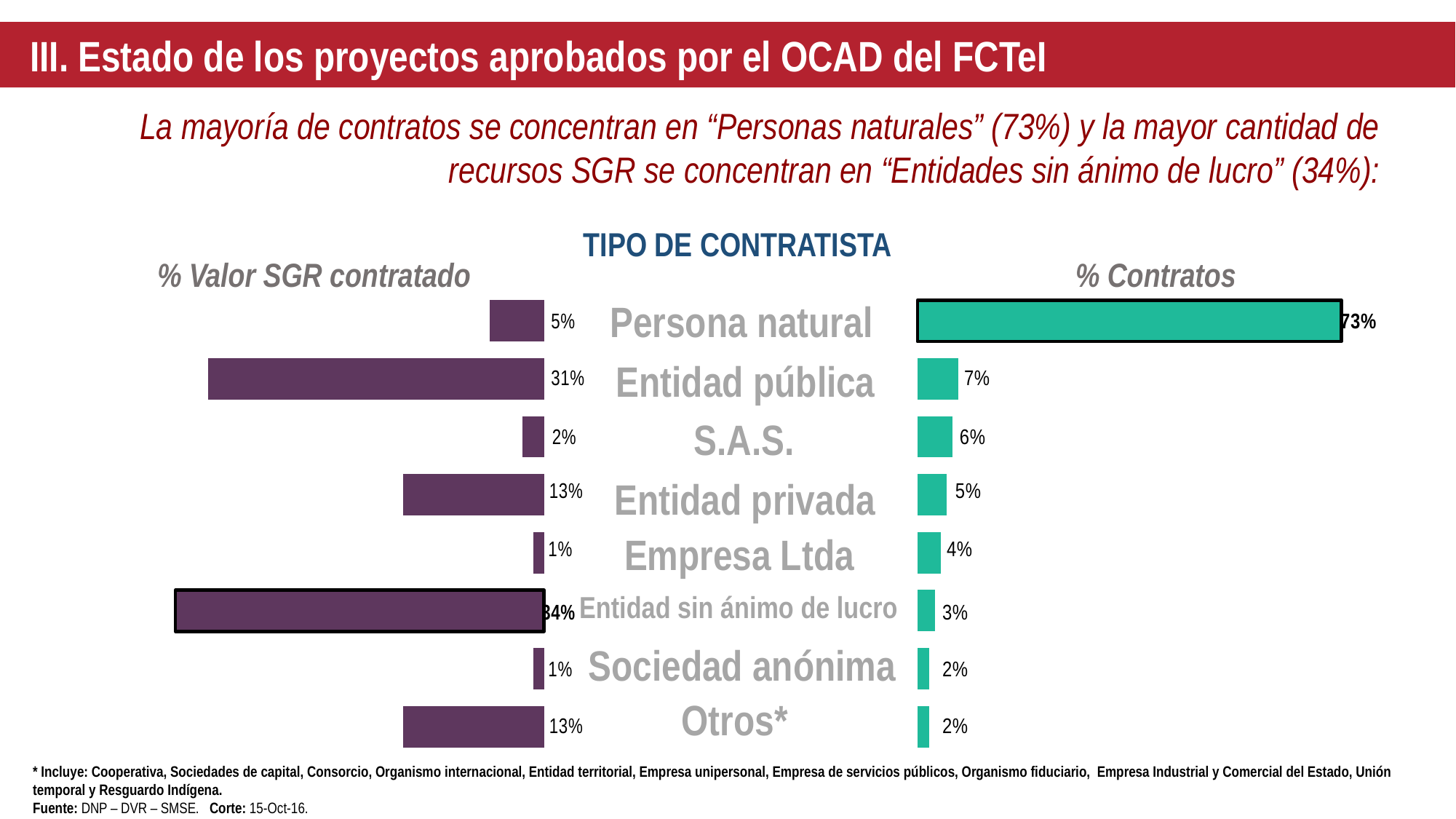
In the "% Valor SGR contratado" chart, which is larger: Entidad privada or Persona natural? Entidad privada What is the title shown above the two charts? TIPO DE CONTRATISTA In the "% Valor SGR contratado" chart, what is the value for Entidad pública? 31% In the "% Contratos" chart, which category has the highest value? Persona natural In the "% Contratos" chart, what is the difference between Persona natural and Entidad pública? 66% How many contractor-type categories are shown in the "% Valor SGR contratado" chart? 8 What type of chart is the "% Contratos" chart? Bar chart In the "% Contratos" chart, what is the value for Persona natural? 73% In the "% Contratos" chart, which is larger: S.A.S. or Empresa Ltda? S.A.S. In the "% Valor SGR contratado" chart, which category has the highest value? Entidad sin ánimo de lucro In the "% Valor SGR contratado" chart, what is the difference between Entidad sin ánimo de lucro and Entidad pública? 3% In the "% Contratos" chart, what is the value for Entidad privada? 5%